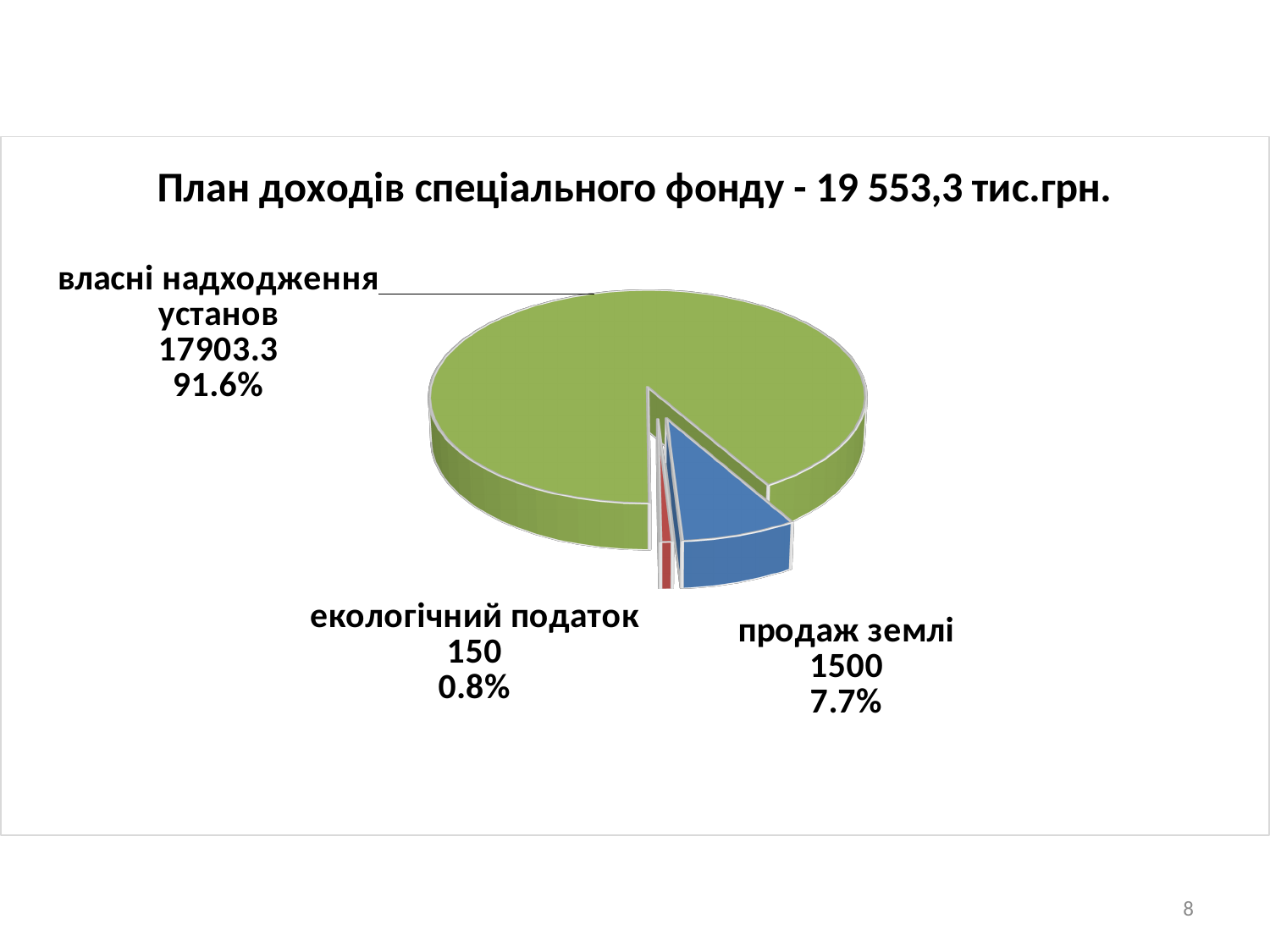
What is the value for продаж землі? 1500 What type of chart is shown on the slide? Pie chart What share of the pie does власні надходження установ represent? 91.6% What is the value for екологічний податок? 150 Which category has the smallest slice? екологічний податок What share of the pie does екологічний податок represent? 0.8% What is the difference between the values for продаж землі and екологічний податок? 1350 What is the title of the chart? План доходів спеціального фонду - 19 553,3 тис.грн. What share of the pie does продаж землі represent? 7.7% How many slices does the pie chart have? 3 What is the value for власні надходження установ? 17903.3 Which category has the largest slice? власні надходження установ